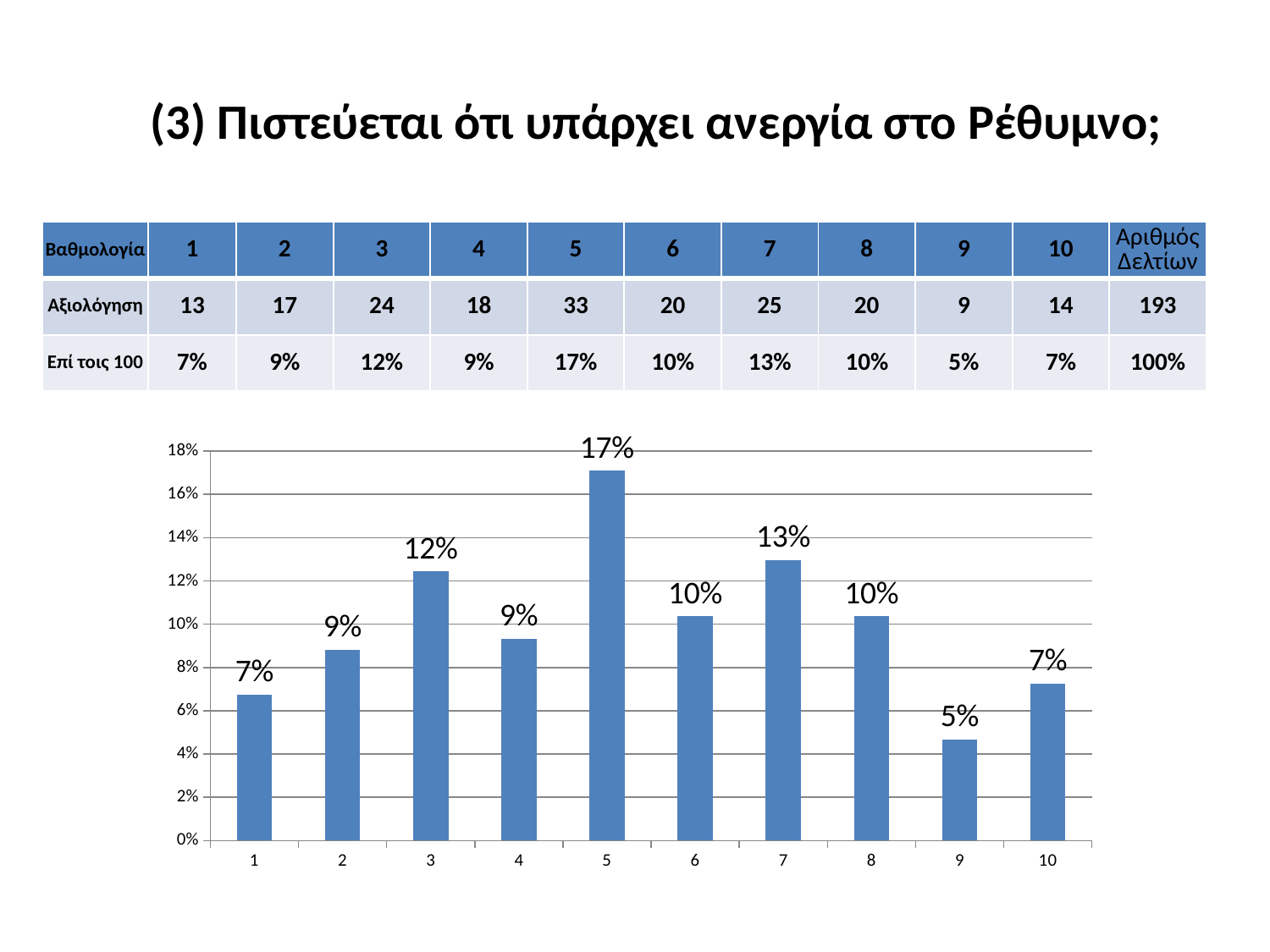
What is the value shown for category 3 in the chart? 12% Which is larger, the value for category 7 or the value for category 3? category 7 How many categories (bars) does the chart show? 10 What is the highest value shown on the chart's vertical axis? 18% What is the value shown for category 5 in the chart? 17% Which category has the lowest value in the chart? 9 What is the value shown for category 9 in the chart? 5% What is the difference between the values for category 7 and category 1? 6% What is the difference between the values for category 5 and category 9? 12% What type of chart is shown on the slide? bar chart Is the value for category 8 greater or less than 8%? greater Which category has the highest value in the chart? 5